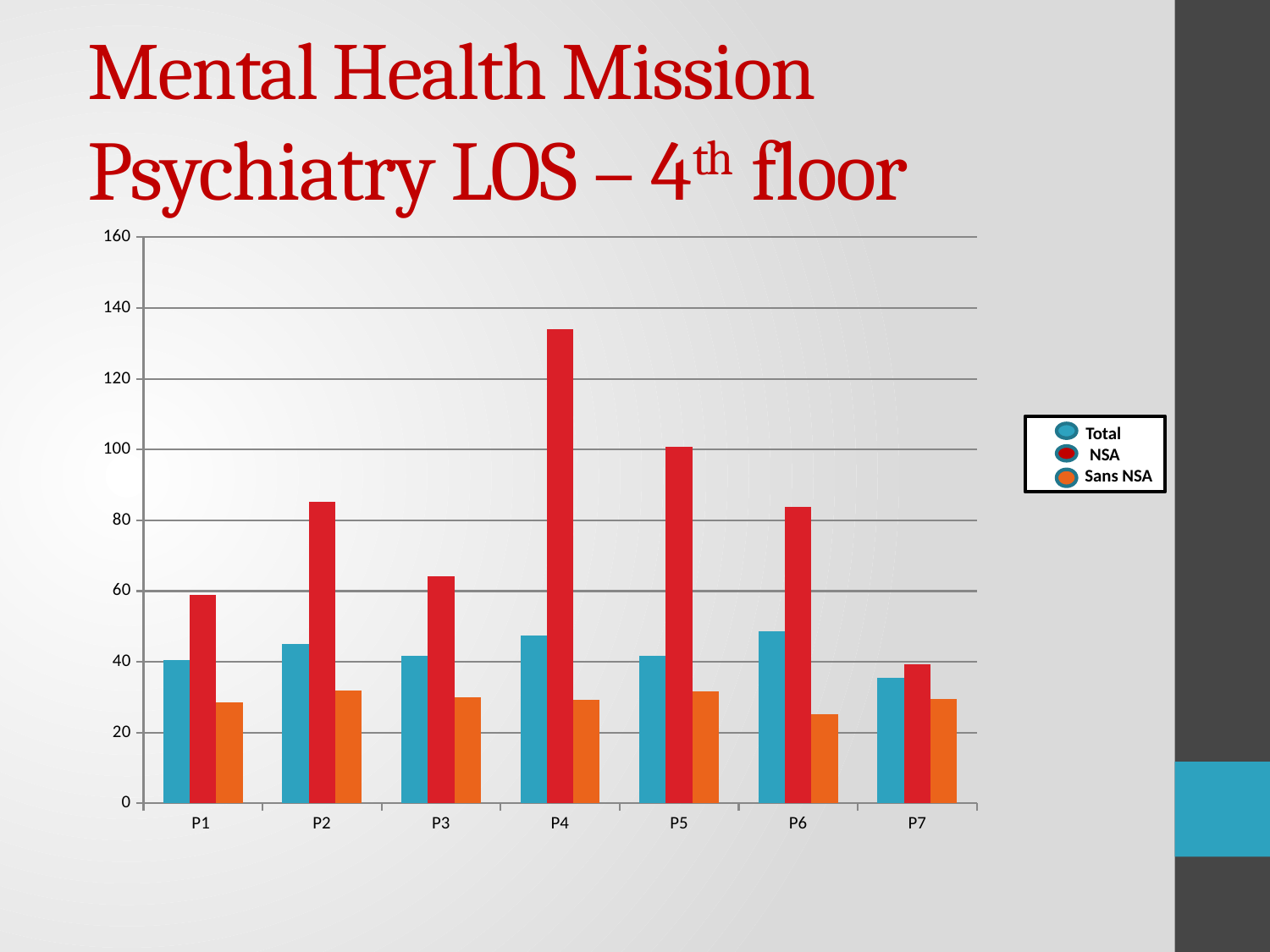
Is the Total value for P7 greater or less than 40? less Do the NSA values rise or fall from P4 to P7? fall For P1, which is larger, the Total value or the NSA value? NSA Which category has the highest NSA value? P4 Is the NSA value for P7 greater or less than 60? less Is the NSA value for P4 greater or less than 120? greater Which category has the lowest NSA value? P7 How many categories are shown on the x axis? 7 Which category has the lowest Total value? P7 What kind of chart is shown on the slide? bar chart Which is larger, the NSA value for P2 or the NSA value for P3? P2 How many series does the legend list? 3